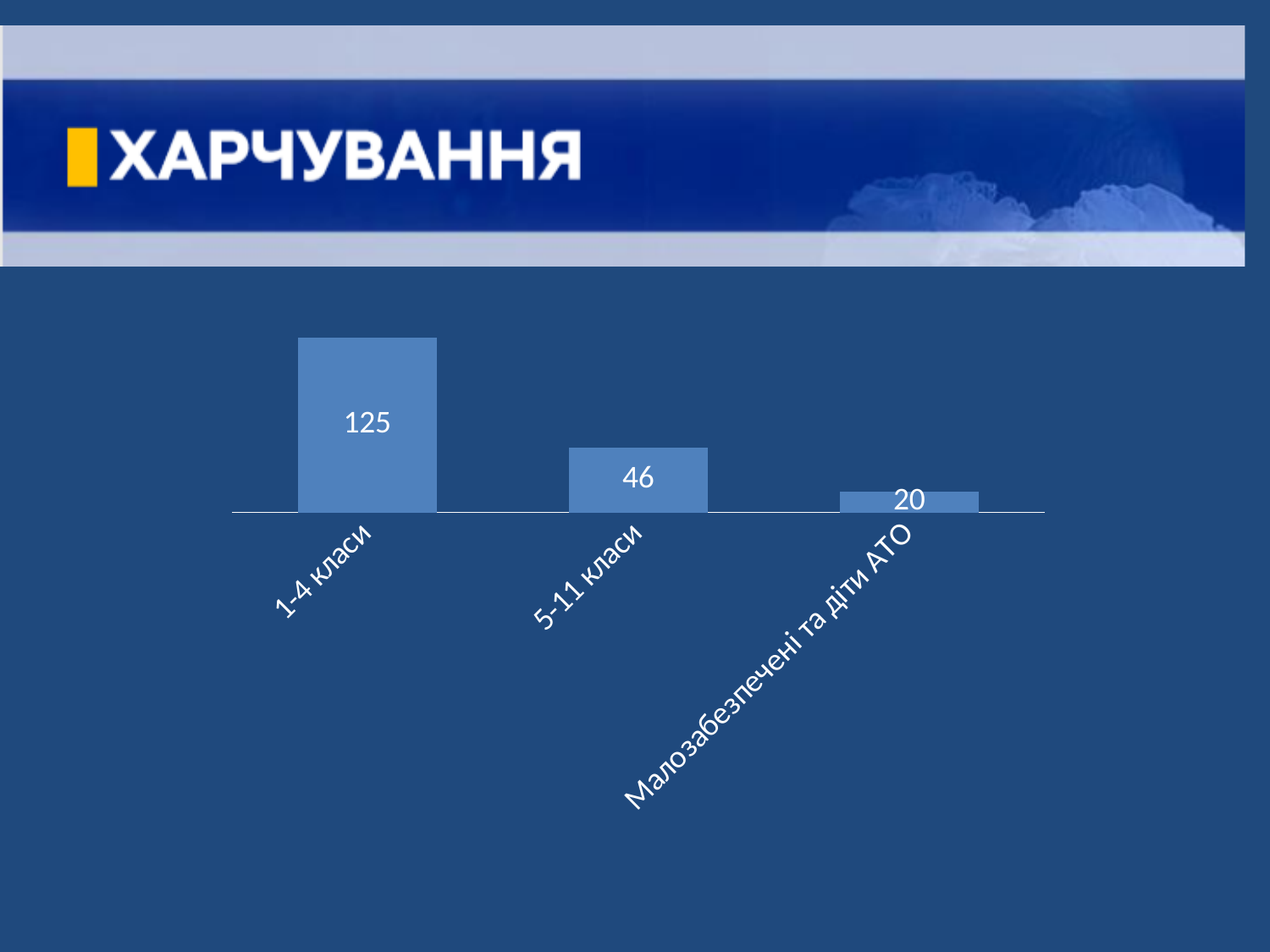
Do the values rise or fall from left to right across the categories? fall What is the value for 5-11 класи? 46 Which is larger, the value for 5-11 класи or the value for Малозабезпечені та діти АТО? 5-11 класи What is the value for Малозабезпечені та діти АТО? 20 What is the value for 1-4 класи? 125 Which category has the highest value? 1-4 класи How many categories are shown in the chart? 3 What is the difference between the values for 5-11 класи and Малозабезпечені та діти АТО? 26 What kind of chart is shown on the slide? bar chart What is the difference between the values for 1-4 класи and 5-11 класи? 79 What is the heading shown in the banner at the top of the slide? ХАРЧУВАННЯ Which category has the lowest value? Малозабезпечені та діти АТО